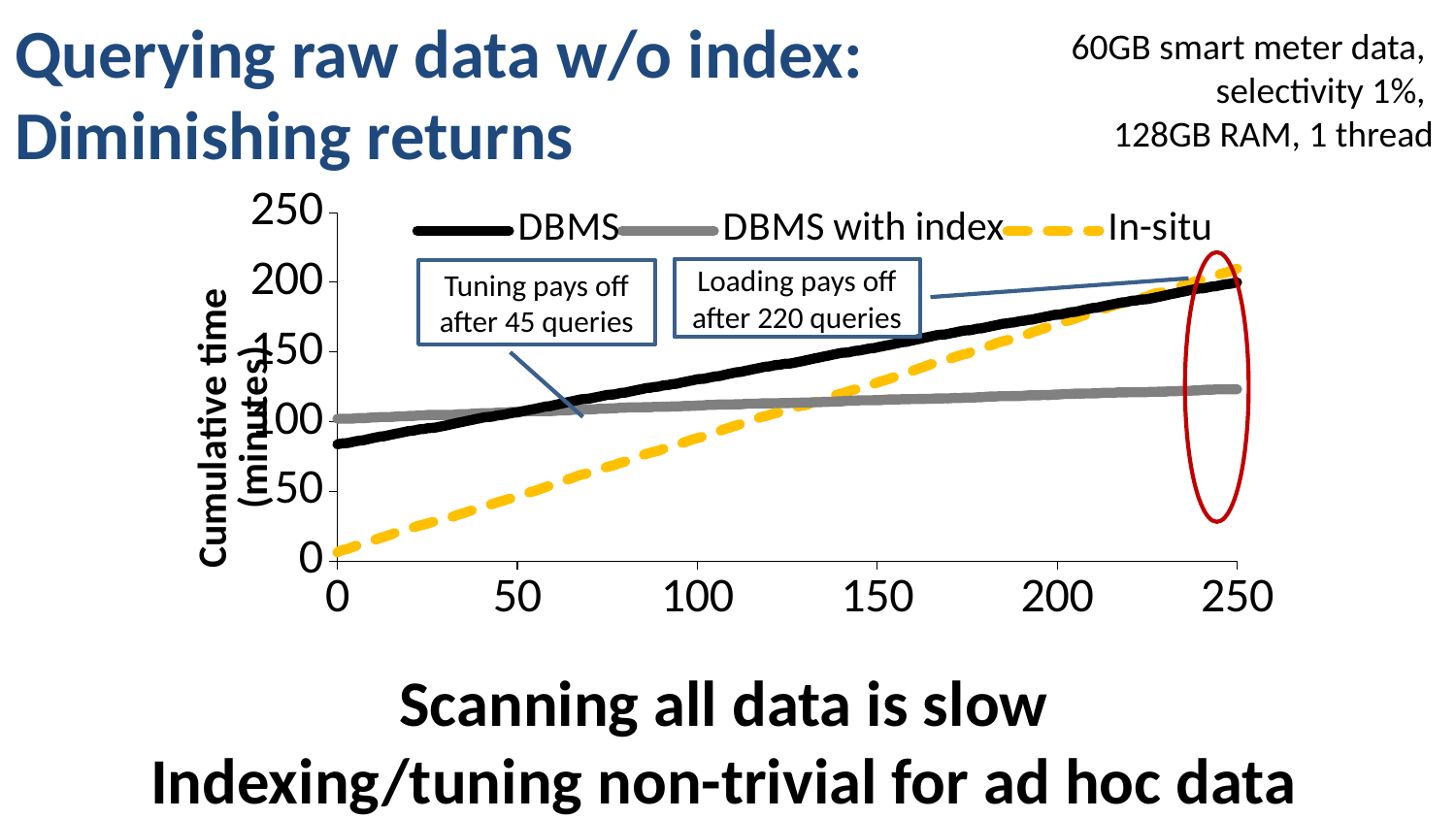
What kind of chart is shown on the slide? line chart Is the cumulative time for DBMS with index at 250 queries greater or less than 150? less Which series has the lowest cumulative time at 250 queries? DBMS with index Which series is plotted with a yellow dashed line? In-situ How many series does the chart's legend list? 3 At 250 queries, which has the larger cumulative time: DBMS or DBMS with index? DBMS Is the cumulative time for In-situ at 0 queries greater or less than 50? less According to the annotation on the chart, after how many queries does tuning pay off? 45 queries Is the cumulative time for DBMS at 250 queries greater or less than 150? greater Does the cumulative time for the In-situ series rise or fall as the number of queries increases? rise Which series has the lowest cumulative time at 0 queries? In-situ Which series has the highest cumulative time at 0 queries? DBMS with index